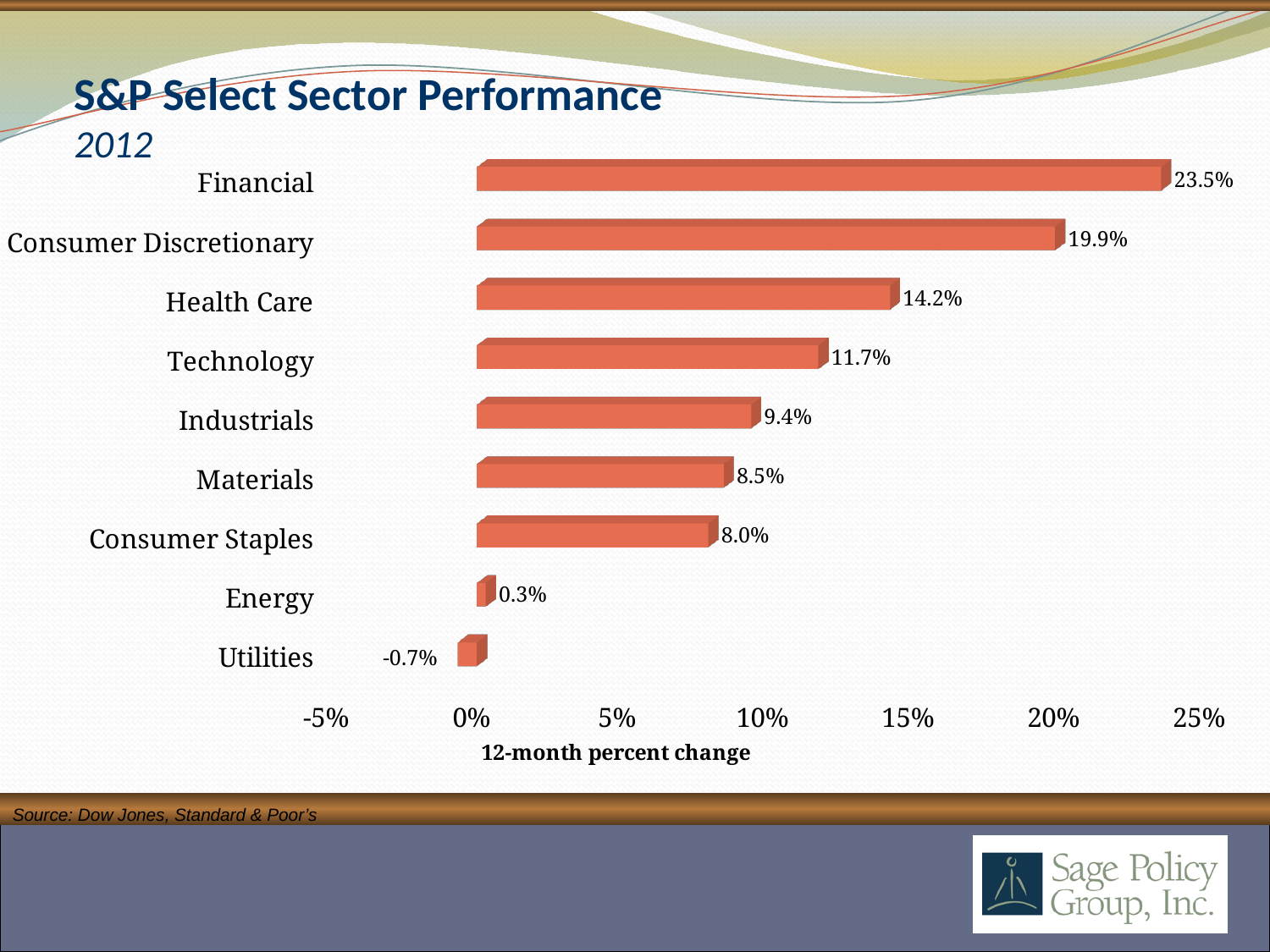
Which sector has the lowest 12-month percent change? Utilities What is the difference between the 12-month percent change for Technology and Industrials? 2.3% How many sectors are shown in the chart? 9 What is the 12-month percent change for Utilities? -0.7% What is the label of the horizontal axis? 12-month percent change Which sector has the highest 12-month percent change? Financial What is the 12-month percent change for Financial? 23.5% What kind of chart is shown on the slide? Bar chart Is the value for Health Care greater or less than 10%? greater Which has a larger 12-month percent change, Materials or Consumer Staples? Materials What is the 12-month percent change for Health Care? 14.2% What is the difference between the 12-month percent change for Financial and Consumer Discretionary? 3.6%